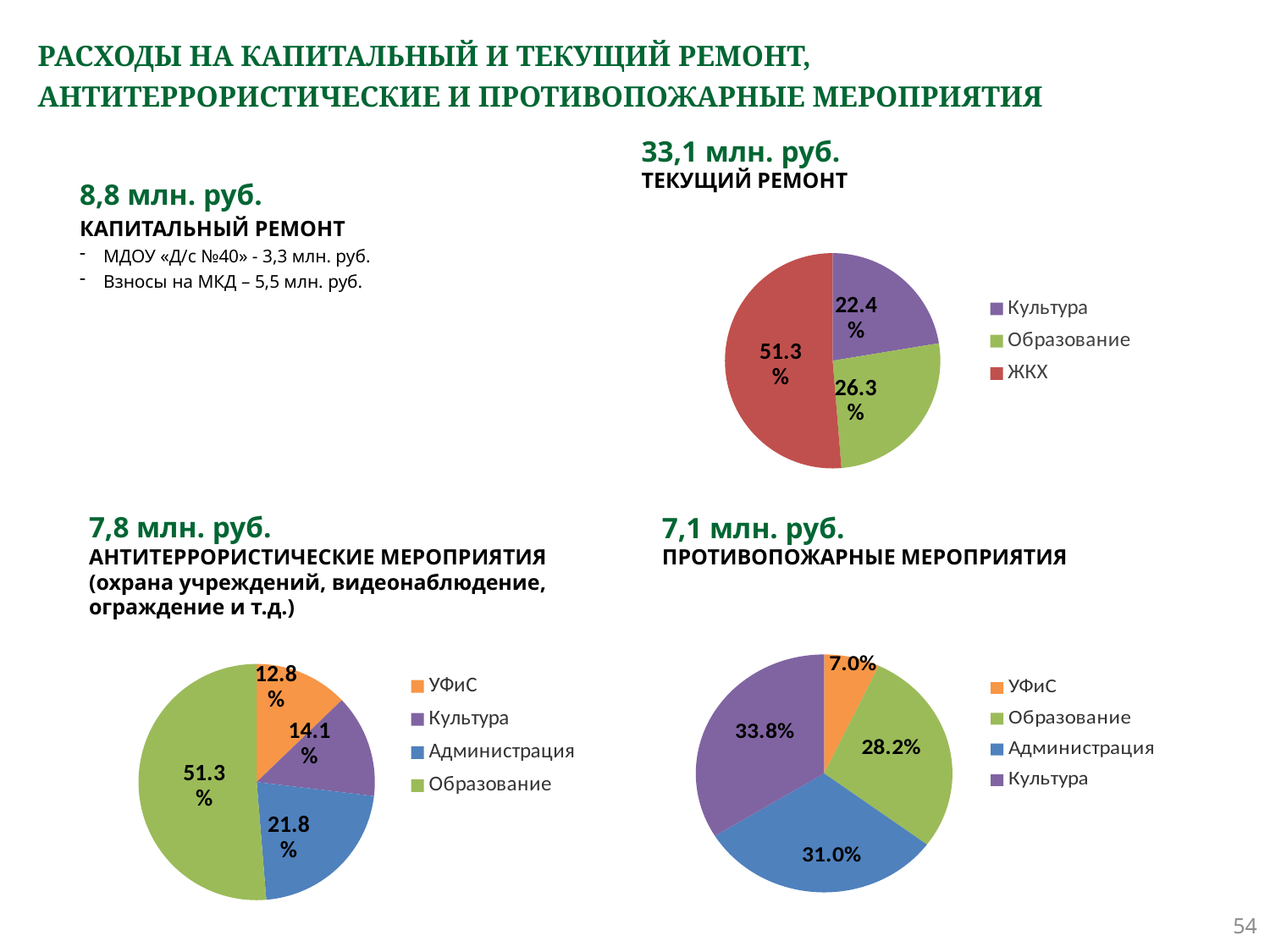
In the "АНТИТЕРРОРИСТИЧЕСКИЕ МЕРОПРИЯТИЯ" pie chart, which category has the largest share? Образование In the "ПРОТИВОПОЖАРНЫЕ МЕРОПРИЯТИЯ" pie chart, which is larger: Администрация or Образование? Администрация In the "ПРОТИВОПОЖАРНЫЕ МЕРОПРИЯТИЯ" pie chart, what share does Культура have? 33.8% In the "АНТИТЕРРОРИСТИЧЕСКИЕ МЕРОПРИЯТИЯ" pie chart, what is the difference between the shares of Администрация and УФиС? 9.0% In the "ТЕКУЩИЙ РЕМОНТ" pie chart, which category has the smallest share? Культура What type of chart is used for "ТЕКУЩИЙ РЕМОНТ"? Pie chart In the "АНТИТЕРРОРИСТИЧЕСКИЕ МЕРОПРИЯТИЯ" pie chart, how many slices are there? 4 In the "ПРОТИВОПОЖАРНЫЕ МЕРОПРИЯТИЯ" pie chart, which category has the smallest share? УФиС In the "ТЕКУЩИЙ РЕМОНТ" pie chart, what share does ЖКХ have? 51.3% In the "АНТИТЕРРОРИСТИЧЕСКИЕ МЕРОПРИЯТИЯ" pie chart, what share does Администрация have? 21.8% In the "ТЕКУЩИЙ РЕМОНТ" pie chart, what share does Культура have? 22.4% In the "ТЕКУЩИЙ РЕМОНТ" pie chart, how many categories does the legend list? 3